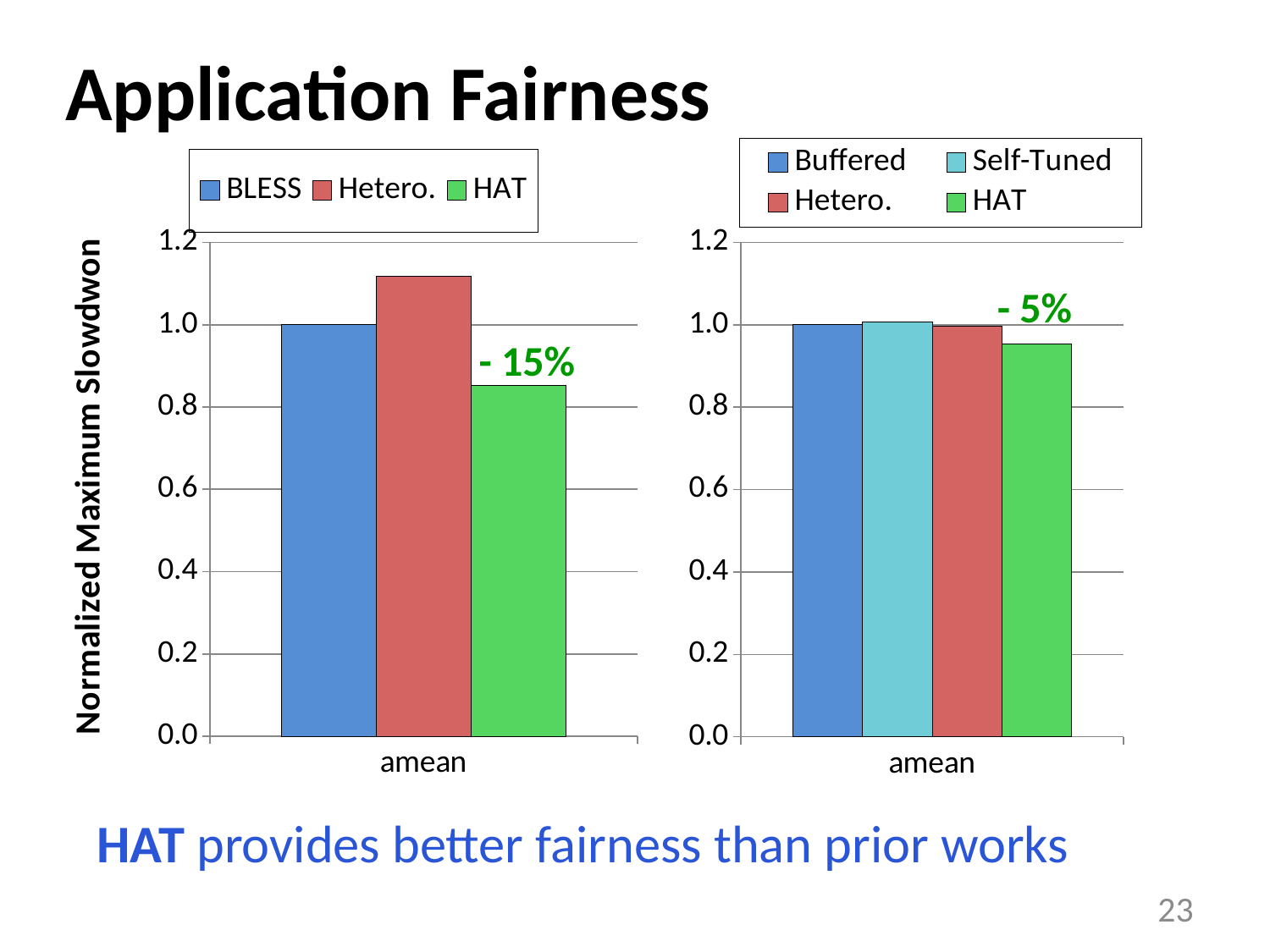
In the left chart, is the value for Hetero. greater or less than 1.0? greater In the left chart, which series has the lowest normalized maximum slowdown? HAT In the left chart, which series has the highest normalized maximum slowdown? Hetero. How many series does the legend of the right chart list? 4 What annotation is printed above the HAT bar in the left chart? - 15% In the right chart, which series has the lowest normalized maximum slowdown? HAT In the left chart, which is larger, the value for Hetero. or the value for HAT? Hetero. How many series does the legend of the left chart list? 3 In the left chart, is the value for HAT greater or less than 1.0? less What kind of chart is the left chart (BLESS / Hetero. / HAT)? bar chart How many categories are shown on the x axis of the right chart? 1 In the right chart, which is larger, the value for Buffered or the value for HAT? Buffered